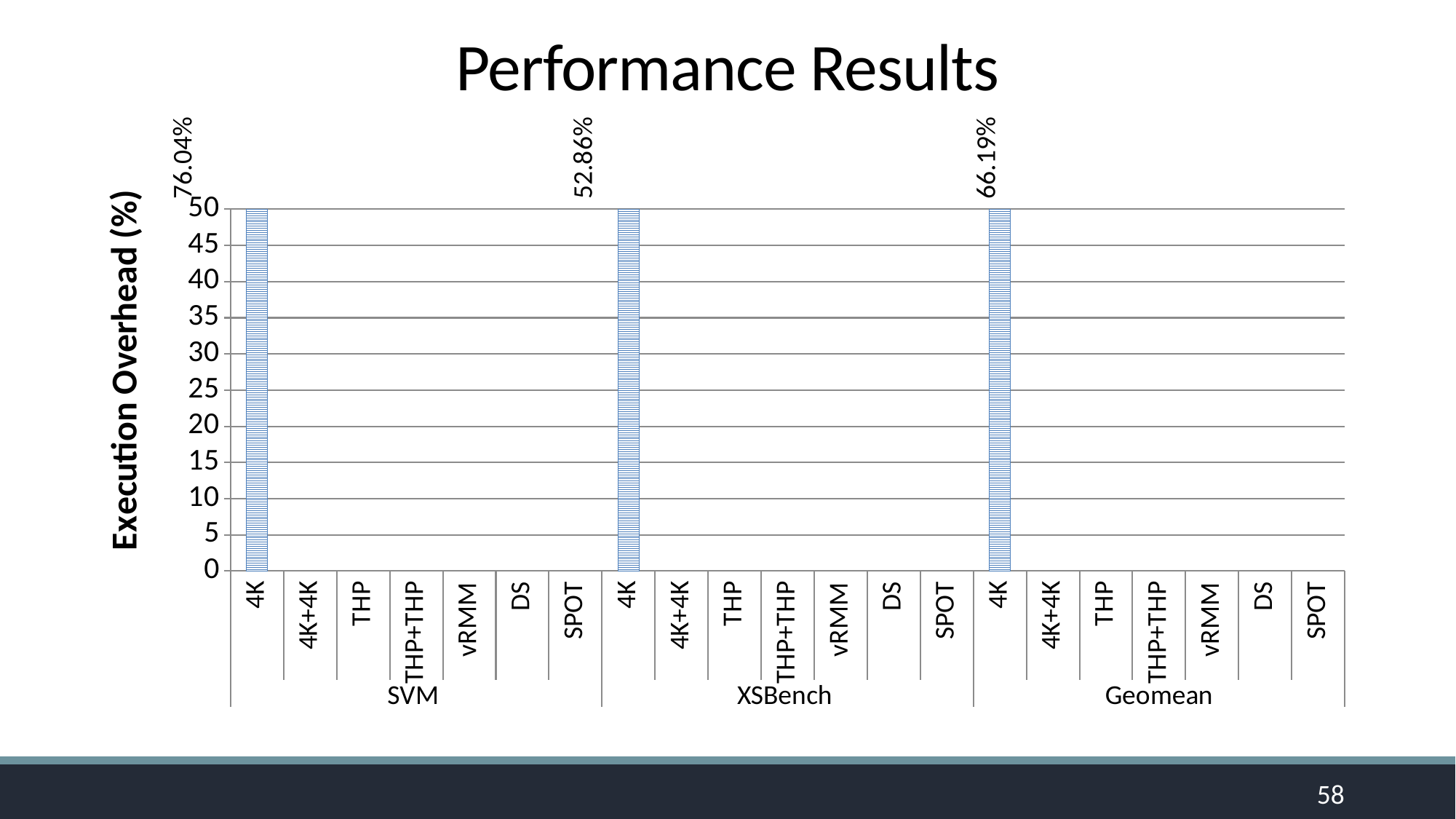
Which group has the highest 4K execution overhead? SVM What is the difference between the 4K execution overhead for SVM and for Geomean? 9.85% Is the 4K execution overhead for XSBench greater or less than 50? greater What is the execution overhead for 4K in the Geomean group? 66.19% Which group has the lowest 4K execution overhead? XSBench How many benchmark groups are shown on the x axis? 3 What is the execution overhead for 4K in the XSBench group? 52.86% Which is larger, the 4K execution overhead for XSBench or for Geomean? Geomean What is the difference between the 4K execution overhead for SVM and for XSBench? 23.18% What kind of chart is shown on the slide? bar chart What is the title of the y axis? Execution Overhead (%) What is the execution overhead for 4K in the SVM group? 76.04%